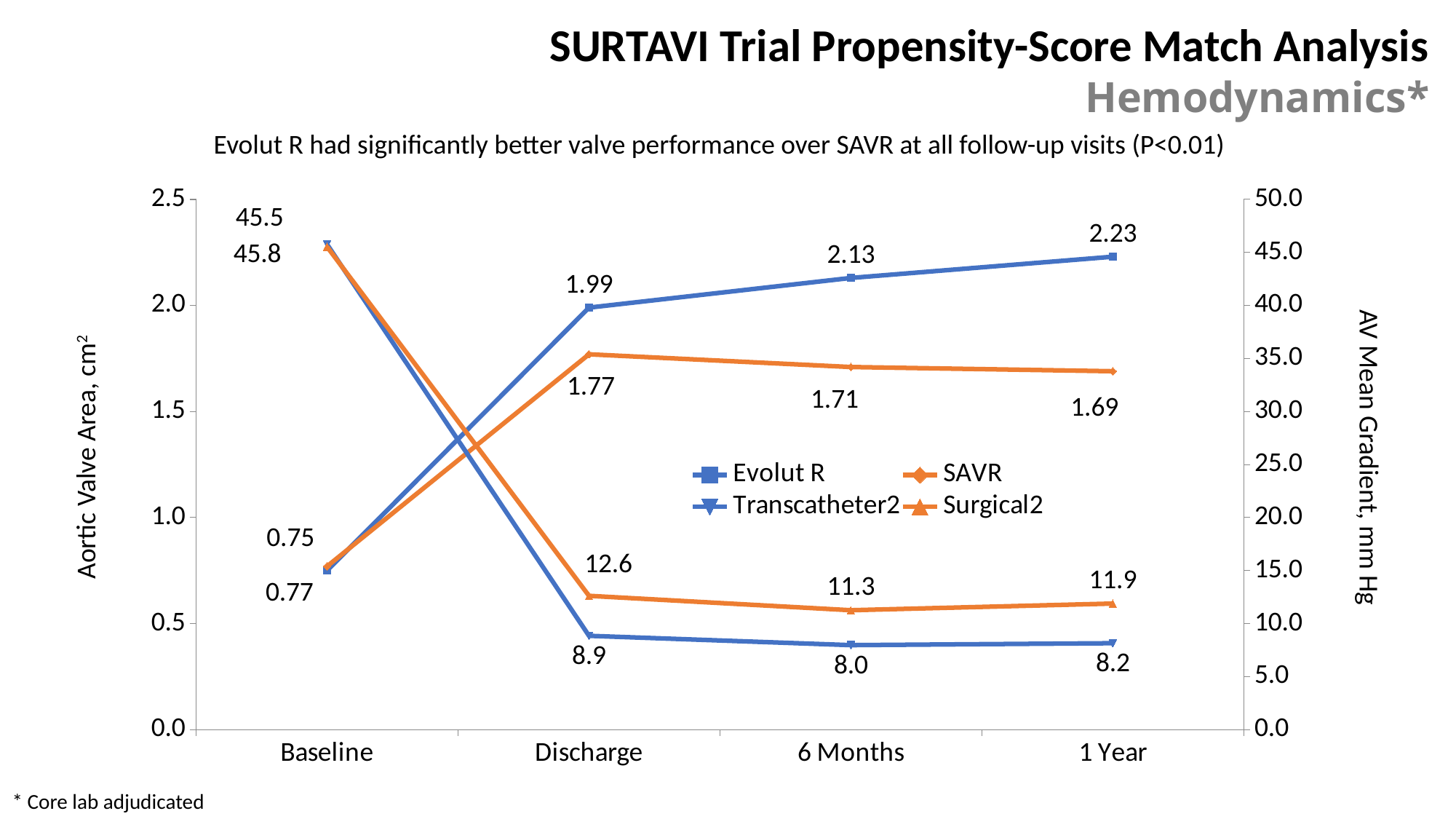
What is the difference between the Surgical2 and Transcatheter2 AV mean gradient values at 1 Year? 3.7 Does the Evolut R aortic valve area rise or fall from Discharge to 1 Year? rise What is the AV mean gradient for Transcatheter2 at Discharge? 8.9 What is the aortic valve area for Evolut R at 1 Year? 2.23 How many time points are shown on the x axis? 4 Which has the larger aortic valve area at 6 Months, Evolut R or SAVR? Evolut R How many series does the legend list? 4 What is the difference between the Evolut R and SAVR aortic valve area values at 1 Year? 0.54 What is the aortic valve area for SAVR at Discharge? 1.77 At which time point is the SAVR aortic valve area highest? Discharge At which time point is the Transcatheter2 AV mean gradient lowest? 6 Months What is the AV mean gradient for Surgical2 at 6 Months? 11.3